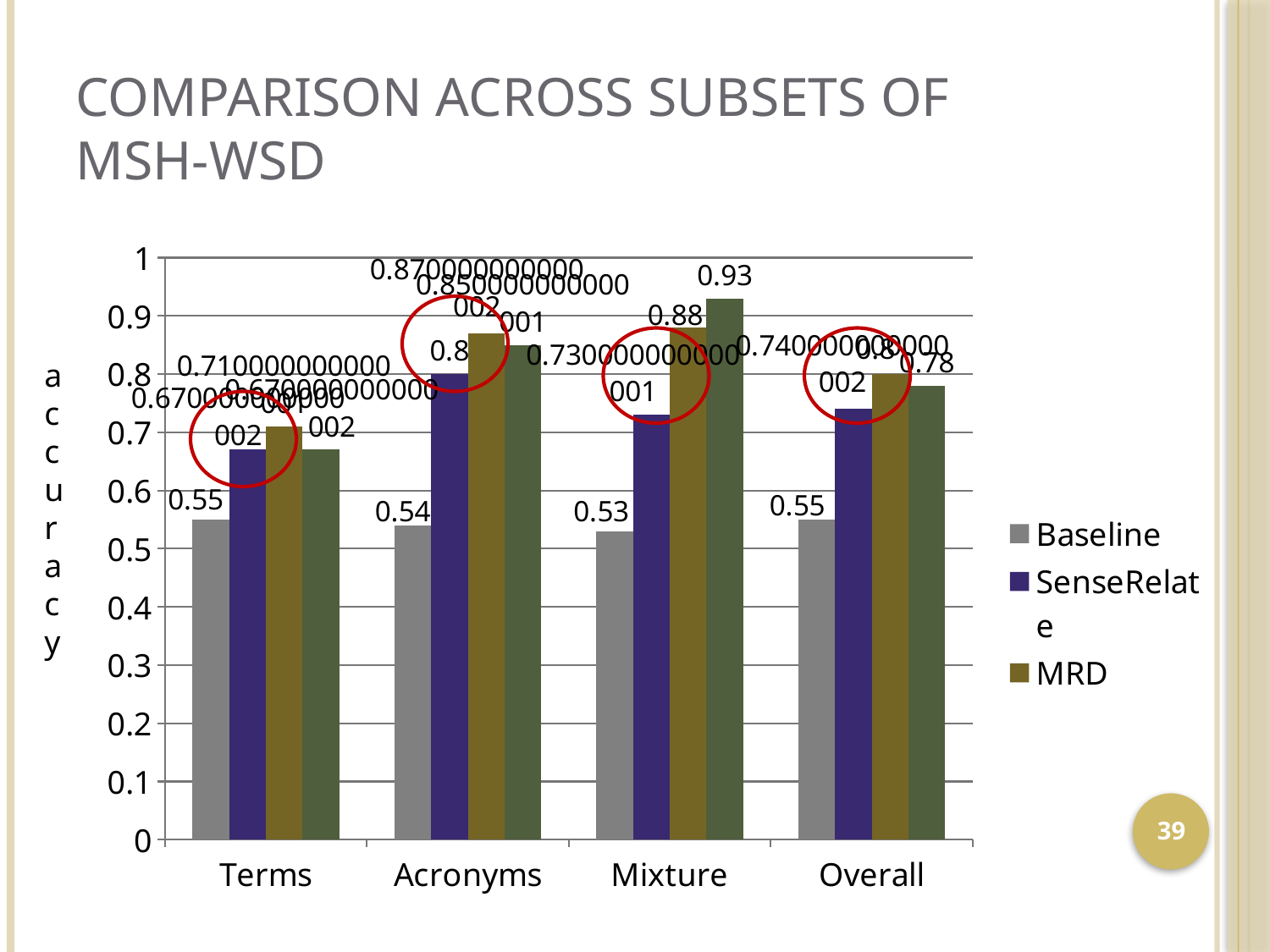
Which is larger: the MRD value for Mixture or the SenseRelate value for Acronyms? MRD value for Mixture How many series does the legend list? 3 What is the difference between the MRD value and the Baseline value for Mixture? 0.35 What is the label on the y axis? accuracy What is the Baseline value for Mixture? 0.53 For which category is the Baseline value lowest? Mixture What type of chart is shown on the slide? bar chart What is the Baseline value for Terms? 0.55 Is the SenseRelate value for Terms greater or less than 0.6? greater What is the SenseRelate value for Acronyms? 0.8 How many categories are shown on the x axis? 4 What is the MRD value for Mixture? 0.88